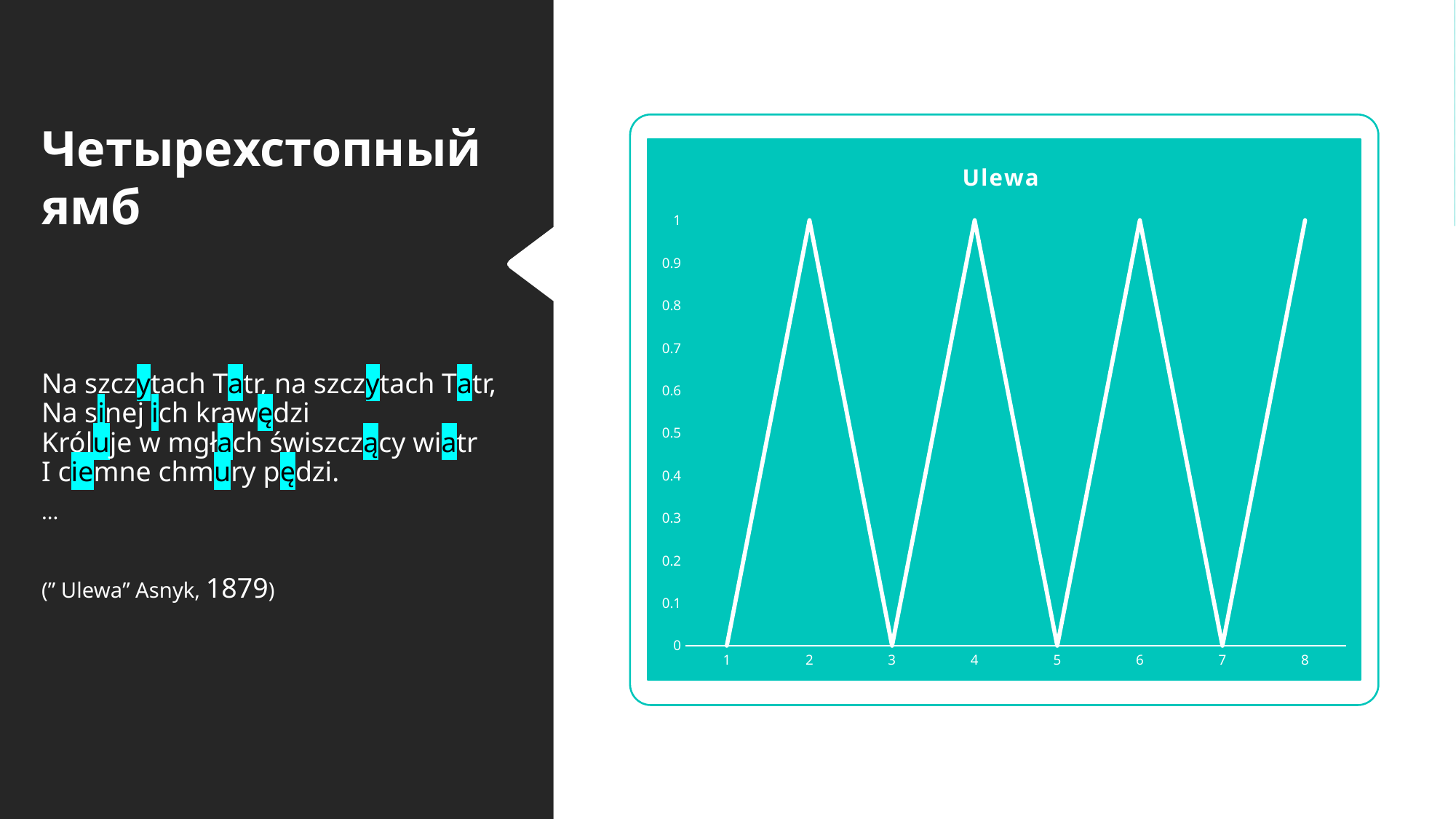
Is the value at x = 7 greater or less than 0.5? less What kind of chart is shown on the slide? line chart How many points are plotted along the x axis of the chart? 8 What is the highest value reached on the y axis by the line? 1 What is the difference between the value at x = 6 and the value at x = 7? 1 Which is larger, the value at x = 4 or the value at x = 5? x = 4 What is the value at x = 3 in the chart? 0 Is the value at x = 4 greater or less than 0.5? greater What is the value at x = 1 in the chart? 0 What is the value at x = 2 in the chart? 1 What is the title of the chart? Ulewa What is the value at x = 8 in the chart? 1